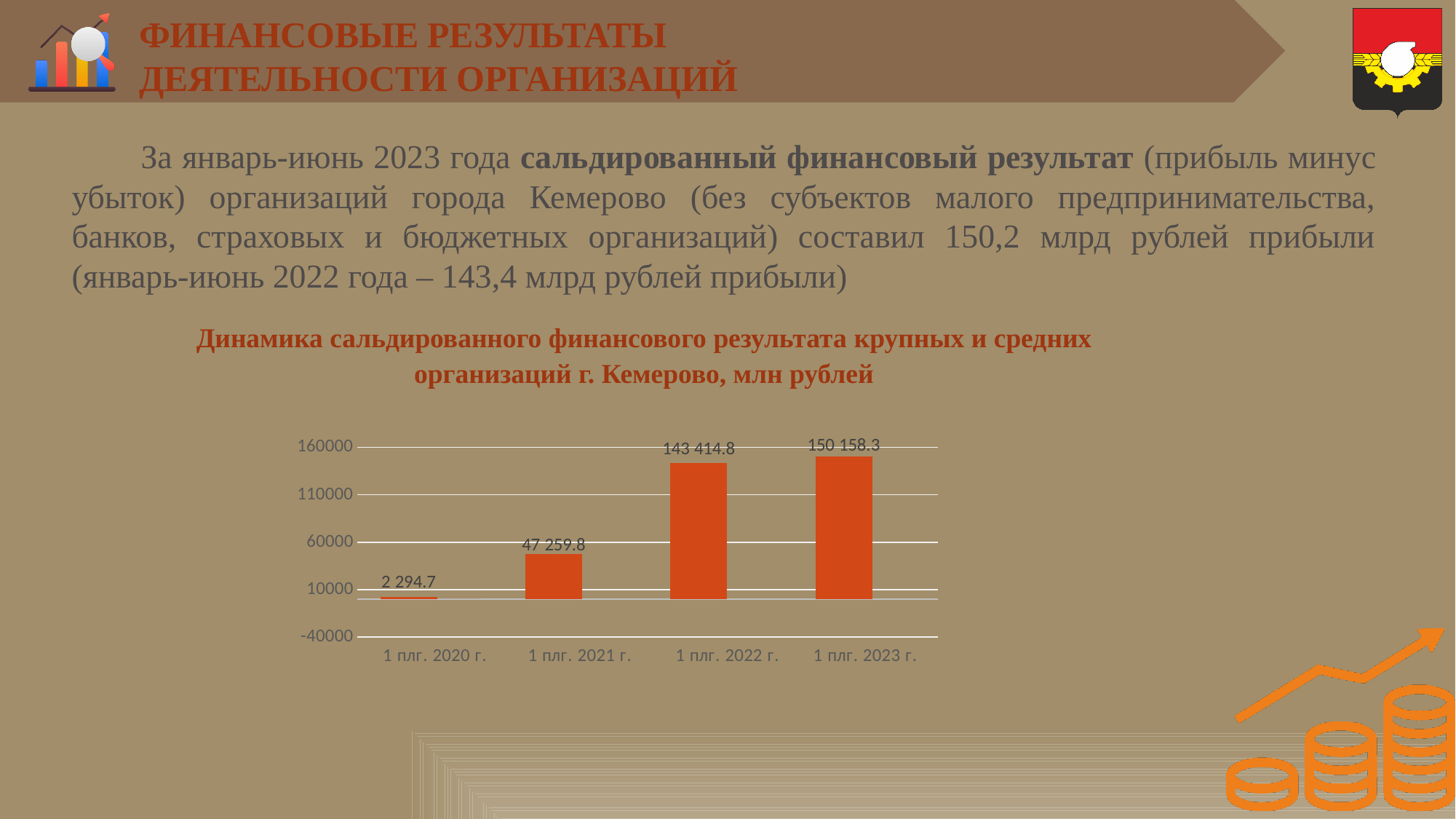
What is the value for 1 плг. 2023 г.? 150 158.3 Which period has the highest value? 1 плг. 2023 г. How many periods are shown on the x axis? 4 What is the value for 1 плг. 2021 г.? 47 259.8 What is the difference between the values for 1 плг. 2023 г. and 1 плг. 2022 г.? 6 743.5 Which period has the lowest value? 1 плг. 2020 г. Is the value for 1 плг. 2021 г. greater or less than 60000? less Which is larger, the value for 1 плг. 2021 г. or 1 плг. 2022 г.? 1 плг. 2022 г. Do the values rise or fall from 1 плг. 2020 г. to 1 плг. 2023 г.? Rise What is the value for 1 плг. 2020 г.? 2 294.7 What is the value for 1 плг. 2022 г.? 143 414.8 What type of chart is shown on the slide? Bar chart